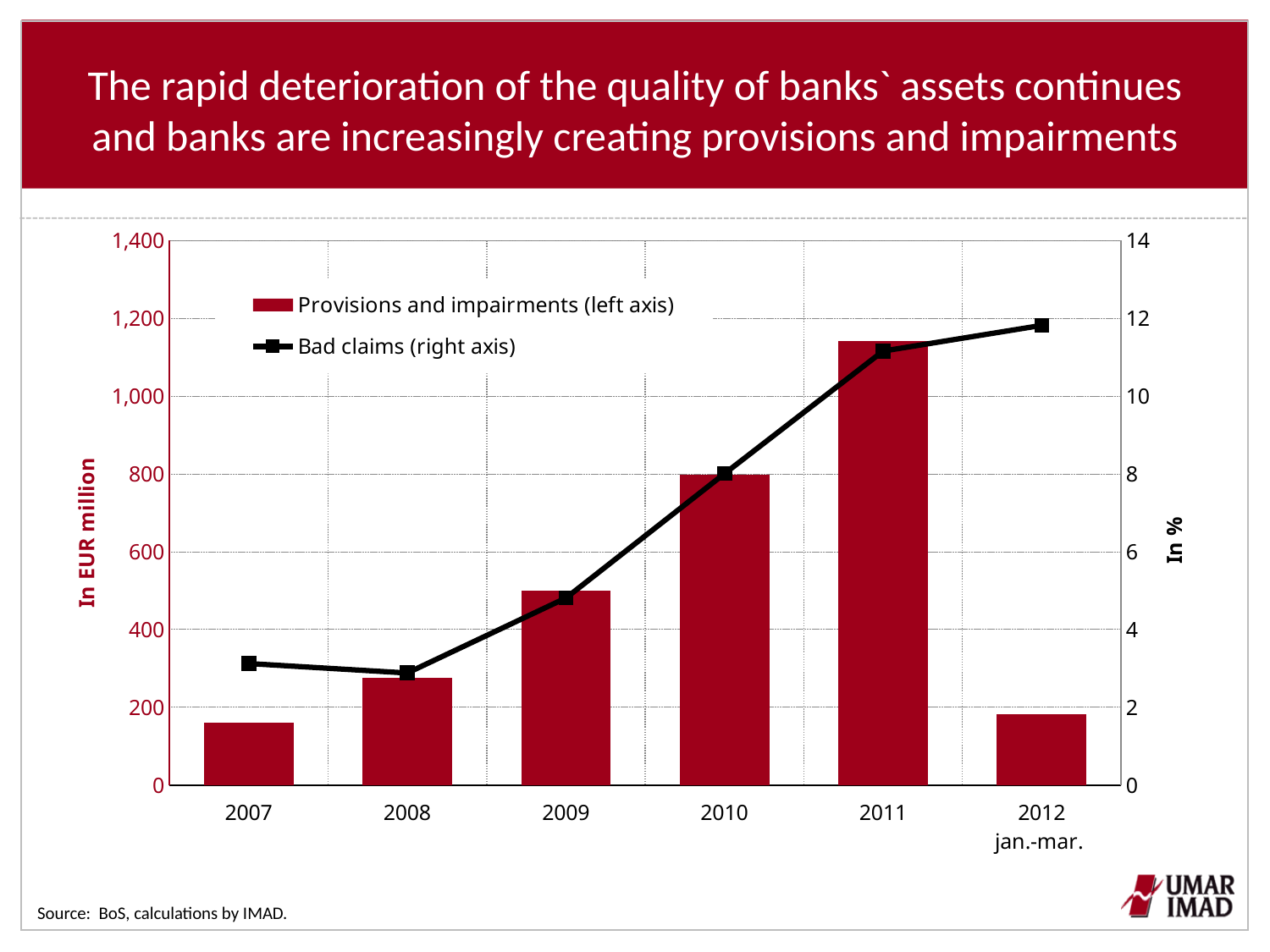
Is the value of Provisions and impairments for 2008 greater or less than 400? less Which is larger, Provisions and impairments in 2009 or in 2012 jan.-mar.? 2009 What is the label of the left vertical axis? In EUR million In which period is the Bad claims value highest? 2012 jan.-mar. Is the value of Provisions and impairments for 2011 greater or less than 1,000? greater In which year is the bar for Provisions and impairments lowest? 2007 Is the value of Bad claims for 2010 greater or less than 6? greater In which year is the bar for Provisions and impairments highest? 2011 Do the Bad claims values rise or fall from 2008 to 2012 jan.-mar.? rise How many series does the legend list? 2 What kind of chart is shown on the slide? A combined bar and line chart How many time periods are shown on the x axis? 6